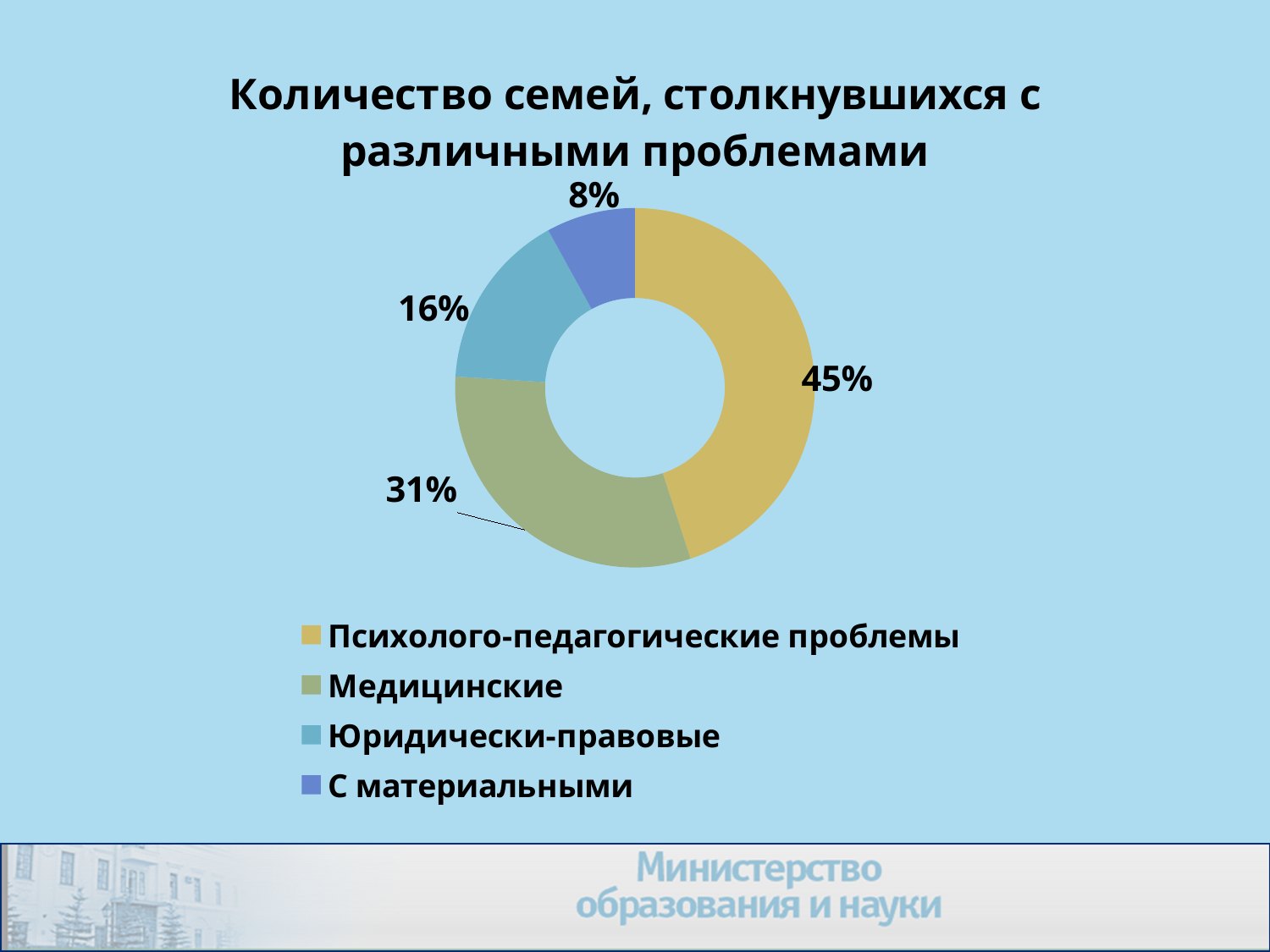
How many categories are shown in the chart? 4 What share of the chart does the 'Психолого-педагогические проблемы' slice represent? 45% Which is larger, the 'Юридически-правовые' slice or the 'С материальными' slice? Юридически-правовые What share of the chart does the 'С материальными' slice represent? 8% Which category has the largest slice? Психолого-педагогические проблемы What share of the chart does the 'Медицинские' slice represent? 31% What is the title of the chart? Количество семей, столкнувшихся с различными проблемами What is the difference in percentage points between the 'Психолого-педагогические проблемы' and 'Медицинские' slices? 14 What kind of chart is shown on the slide? Pie chart (doughnut) Which category has the smallest slice? С материальными What colour is the 'Медицинские' slice? Green